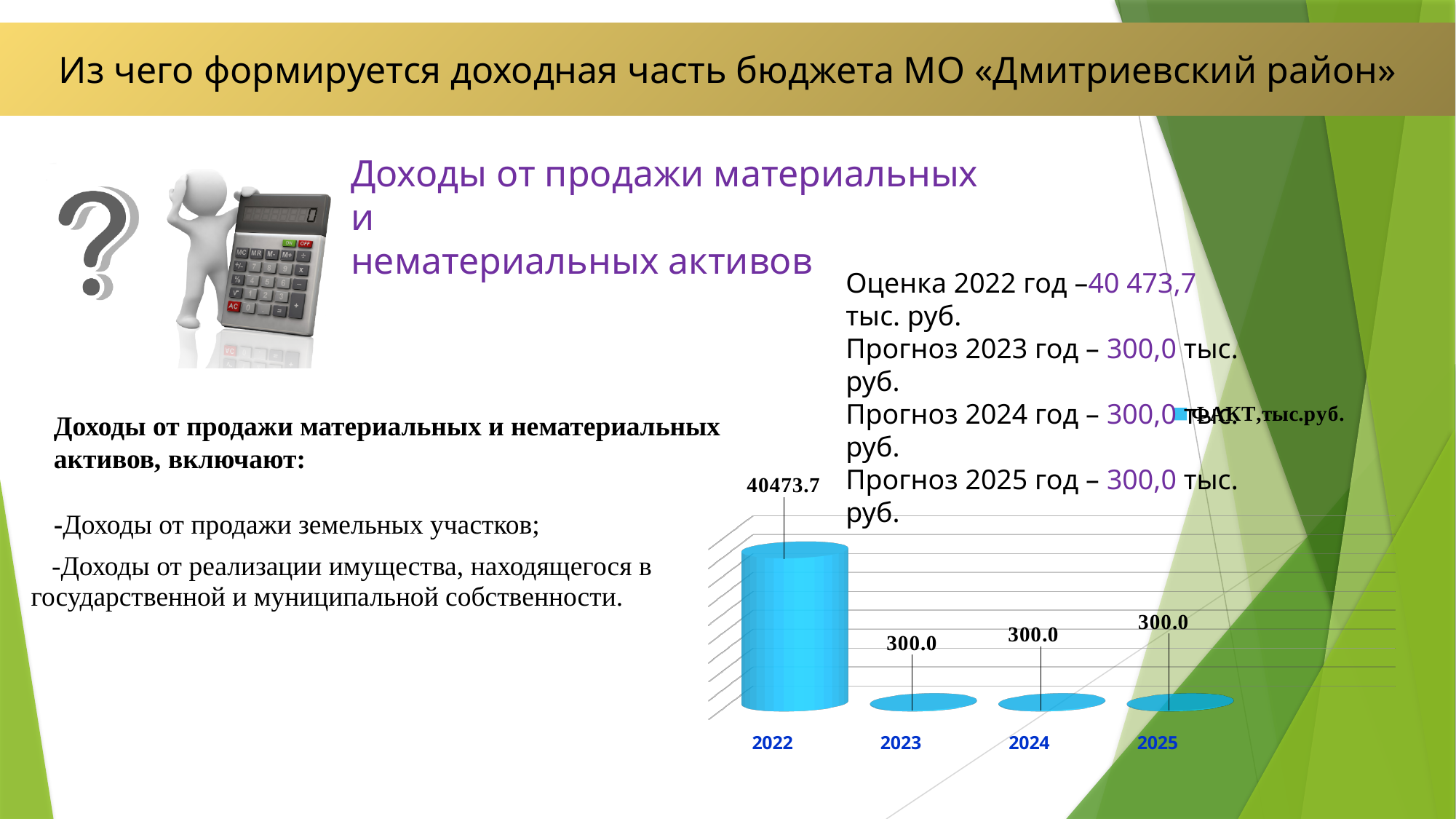
Do the values rise or fall from 2022 to 2023 on the chart? fall What colour are the bars on the chart? blue What is the difference between the values for 2022 and 2023? 40173.7 Are the values for 2023, 2024 and 2025 the same or different? the same Which is larger, the value for 2022 or the value for 2024? 2022 What kind of chart is shown on the slide? bar chart What is the value for 2025 on the chart? 300.0 Which year has the highest value on the chart? 2022 What is the value for 2022 on the chart? 40473.7 What is the value for 2023 on the chart? 300.0 How many years are shown on the chart's x axis? 4 How many series does the chart legend list? 1